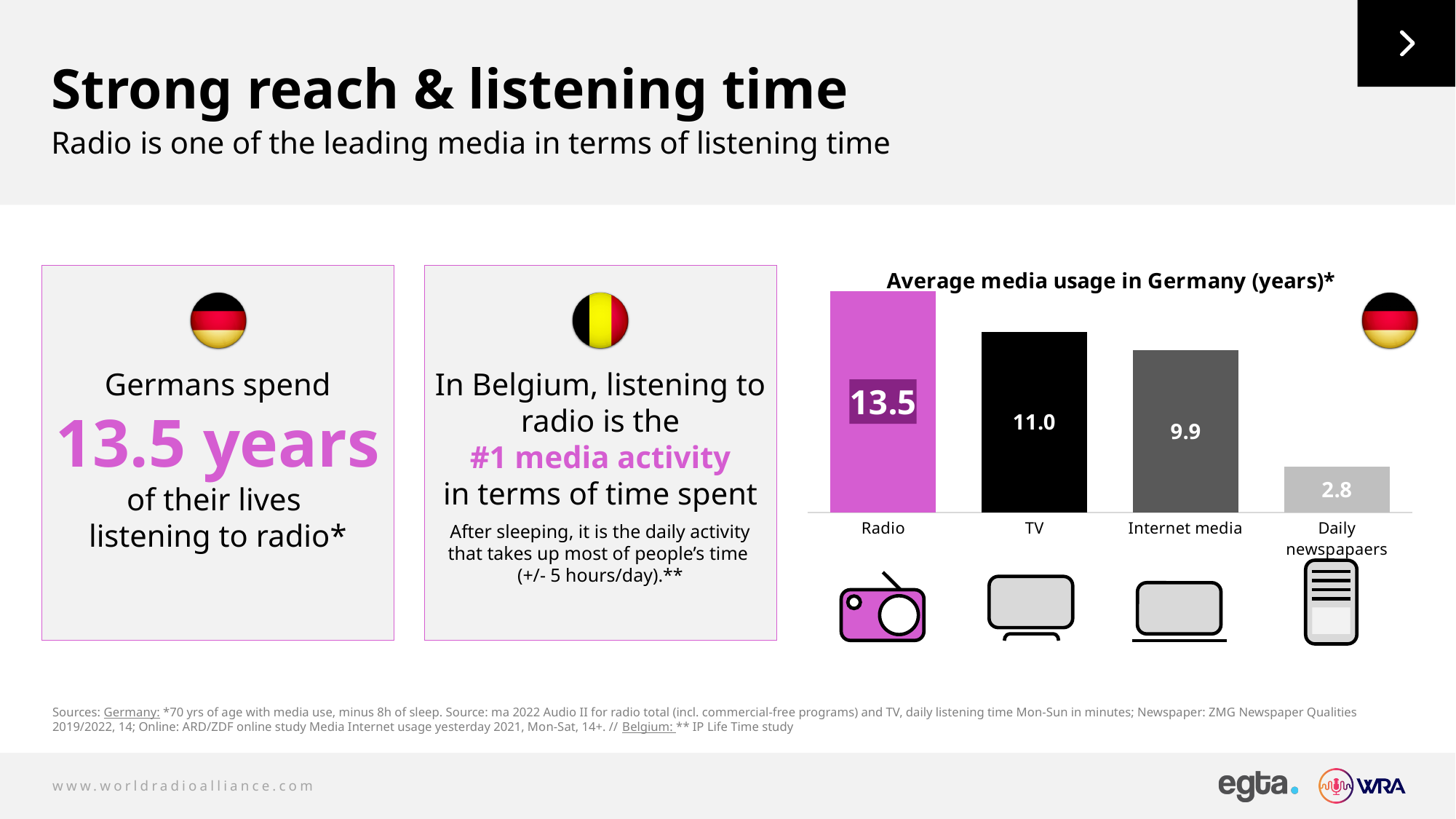
How many categories are shown in the chart? 4 What is the value for Radio in the chart? 13.5 Which category has the lowest value in the chart? Daily newspapers What is the value for Daily newspapers in the chart? 2.8 Which category has the highest value in the chart? Radio What kind of chart is shown on the slide? Bar chart What is the value for TV in the chart? 11.0 Which is larger, the value for TV or the value for Internet media? TV What is the difference between the values for TV and Daily newspapers? 8.2 What is the title of the chart? Average media usage in Germany (years)* What is the difference between the values for Radio and TV? 2.5 What is the value for Internet media in the chart? 9.9